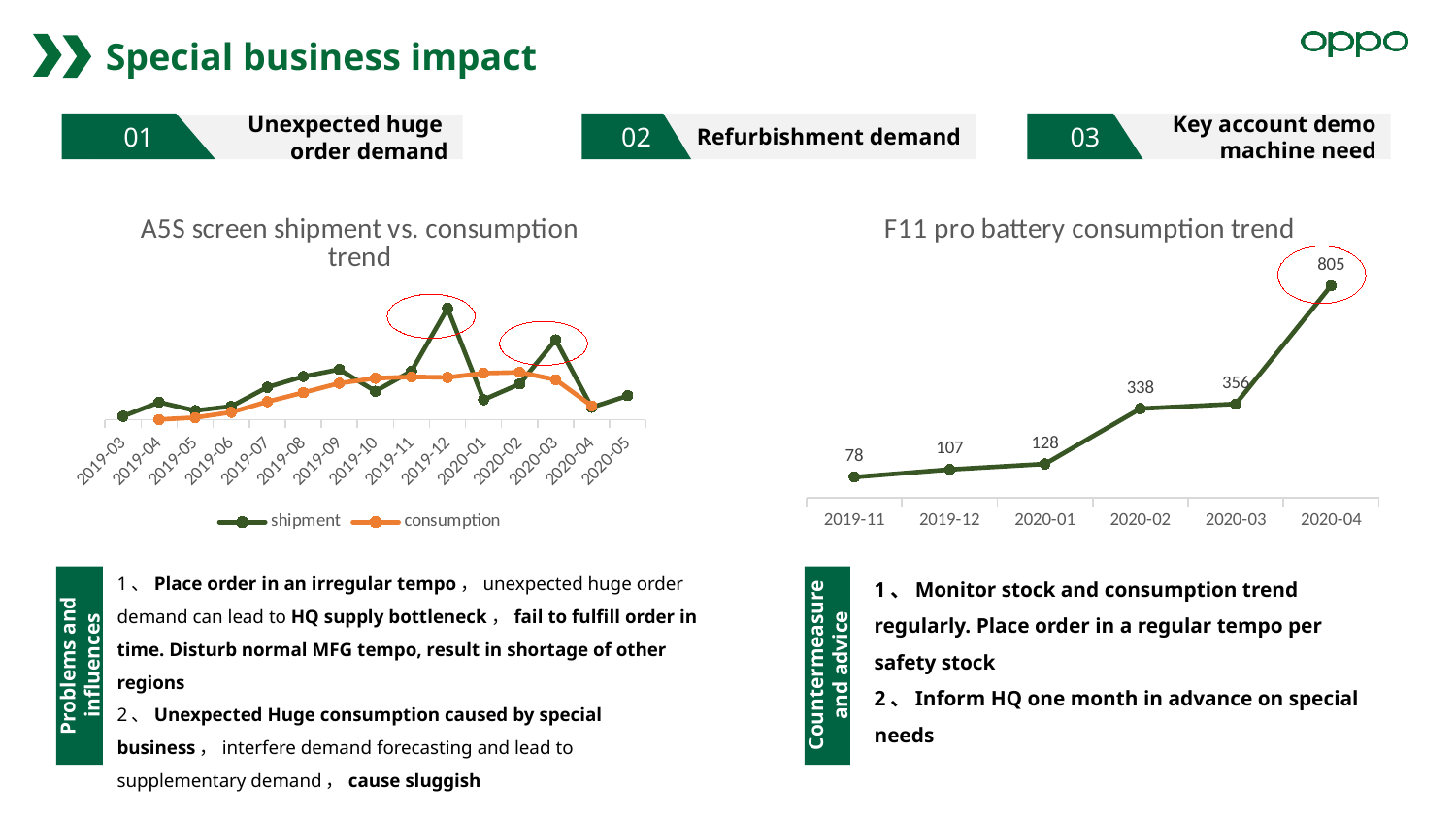
In the 'F11 pro battery consumption trend' chart, what is the difference between the values for 2020-04 and 2020-03? 449 In the 'F11 pro battery consumption trend' chart, which is larger, the value for 2019-12 or the value for 2020-01? 2020-01 How many months are plotted in the 'F11 pro battery consumption trend' chart? 6 In the 'A5S screen shipment vs. consumption trend' chart, in which month does the shipment series reach its highest point? 2019-12 How many series does the legend of the 'A5S screen shipment vs. consumption trend' chart list? 2 In the 'F11 pro battery consumption trend' chart, what is the value for 2019-11? 78 In the 'F11 pro battery consumption trend' chart, what is the value for 2020-04? 805 What kind of chart is the 'A5S screen shipment vs. consumption trend' chart? line chart Do the values in the 'F11 pro battery consumption trend' chart rise or fall from 2019-11 to 2020-04? rise In the 'F11 pro battery consumption trend' chart, which month has the highest value? 2020-04 In the 'F11 pro battery consumption trend' chart, what is the value for 2020-02? 338 In the 'F11 pro battery consumption trend' chart, which month has the lowest value? 2019-11